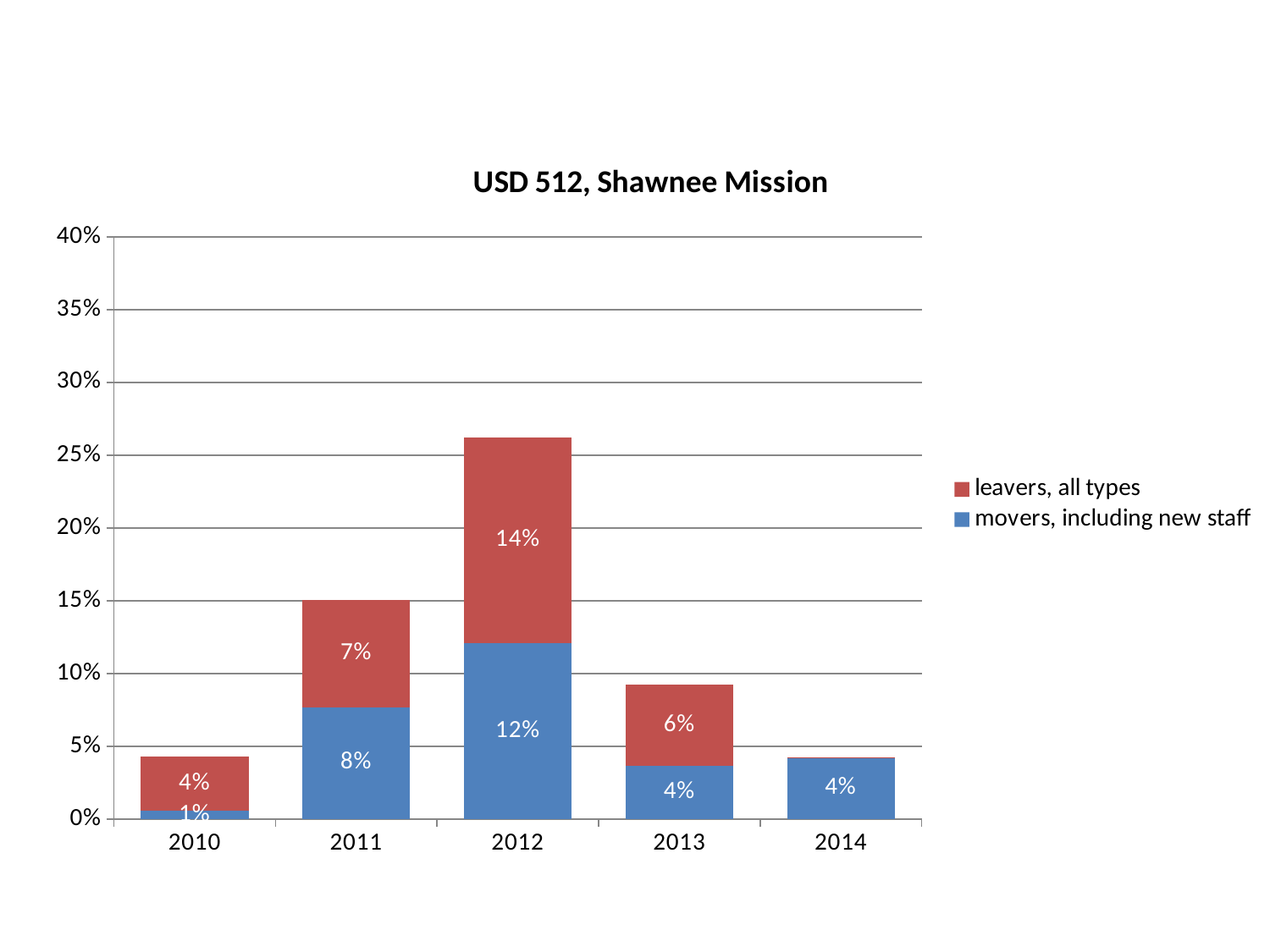
What is the value for movers, including new staff in 2014? 4% What is the value for movers, including new staff in 2012? 12% What is the difference between leavers, all types and movers, including new staff in 2012? 2% Is the total height of the 2010 bar greater or less than 5%? less What kind of chart is shown on the slide? stacked bar chart What is the total of the stacked bar for 2011? 15% In 2011, which is larger: movers, including new staff or leavers, all types? movers, including new staff In which year is the movers, including new staff value lowest? 2010 How many series does the legend list? 2 What is the value for leavers, all types in 2013? 6% In which year is the leavers, all types value highest? 2012 How many years are shown on the x axis? 5